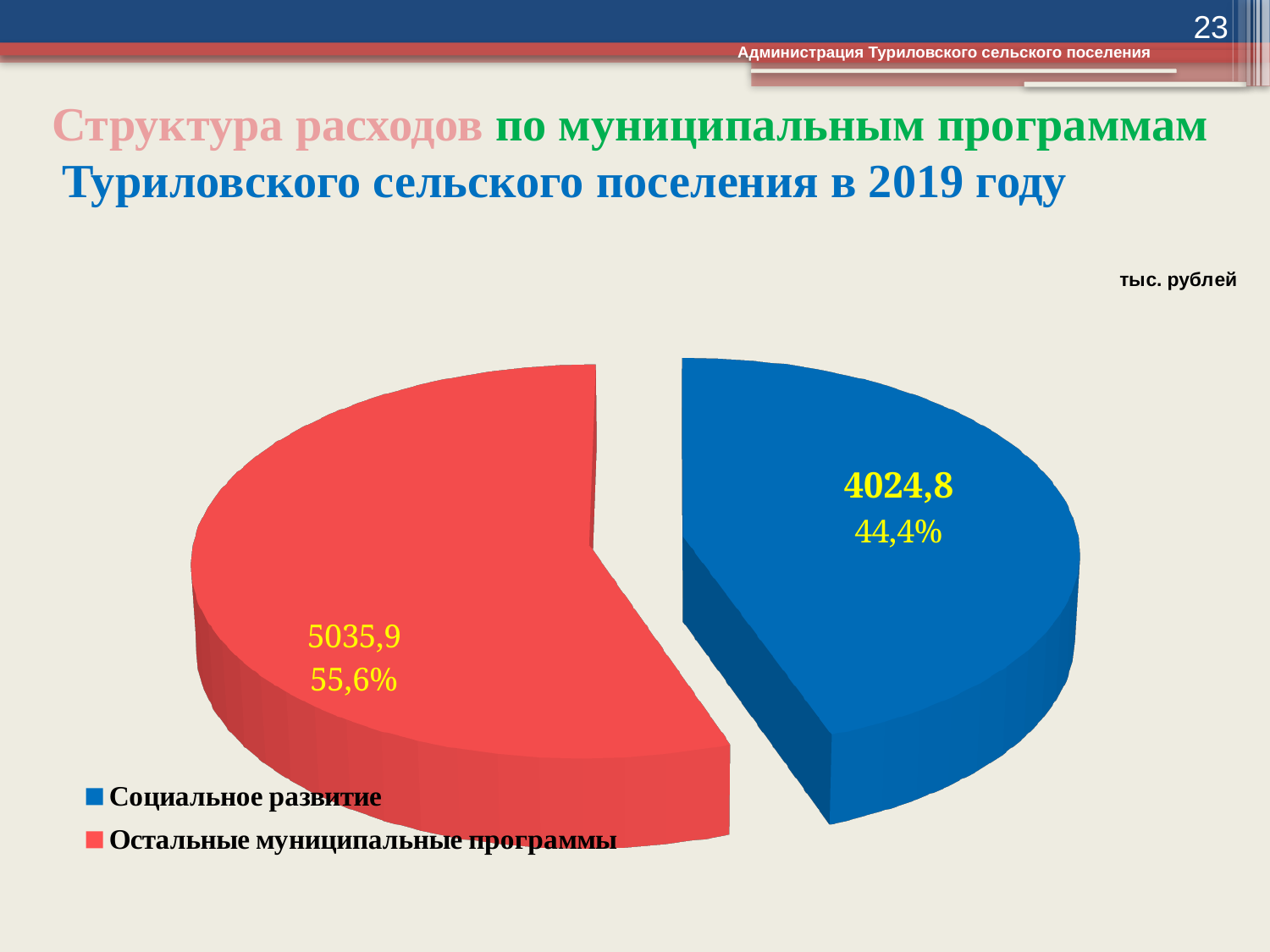
What is the total of the two slice values? 9060,7 Which category has the largest slice? Остальные муниципальные программы Which is larger: Социальное развитие or Остальные муниципальные программы? Остальные муниципальные программы What is the difference between the values for Остальные муниципальные программы and Социальное развитие? 1011,1 How many slices does the pie chart have? 2 Which category has the smallest slice? Социальное развитие What colour is the slice for Социальное развитие? Blue What share of the pie does Остальные муниципальные программы represent? 55,6% What share of the pie does Социальное развитие represent? 44,4% What type of chart is shown on the slide? Pie chart What is the value for Остальные муниципальные программы? 5035,9 What is the value for Социальное развитие? 4024,8